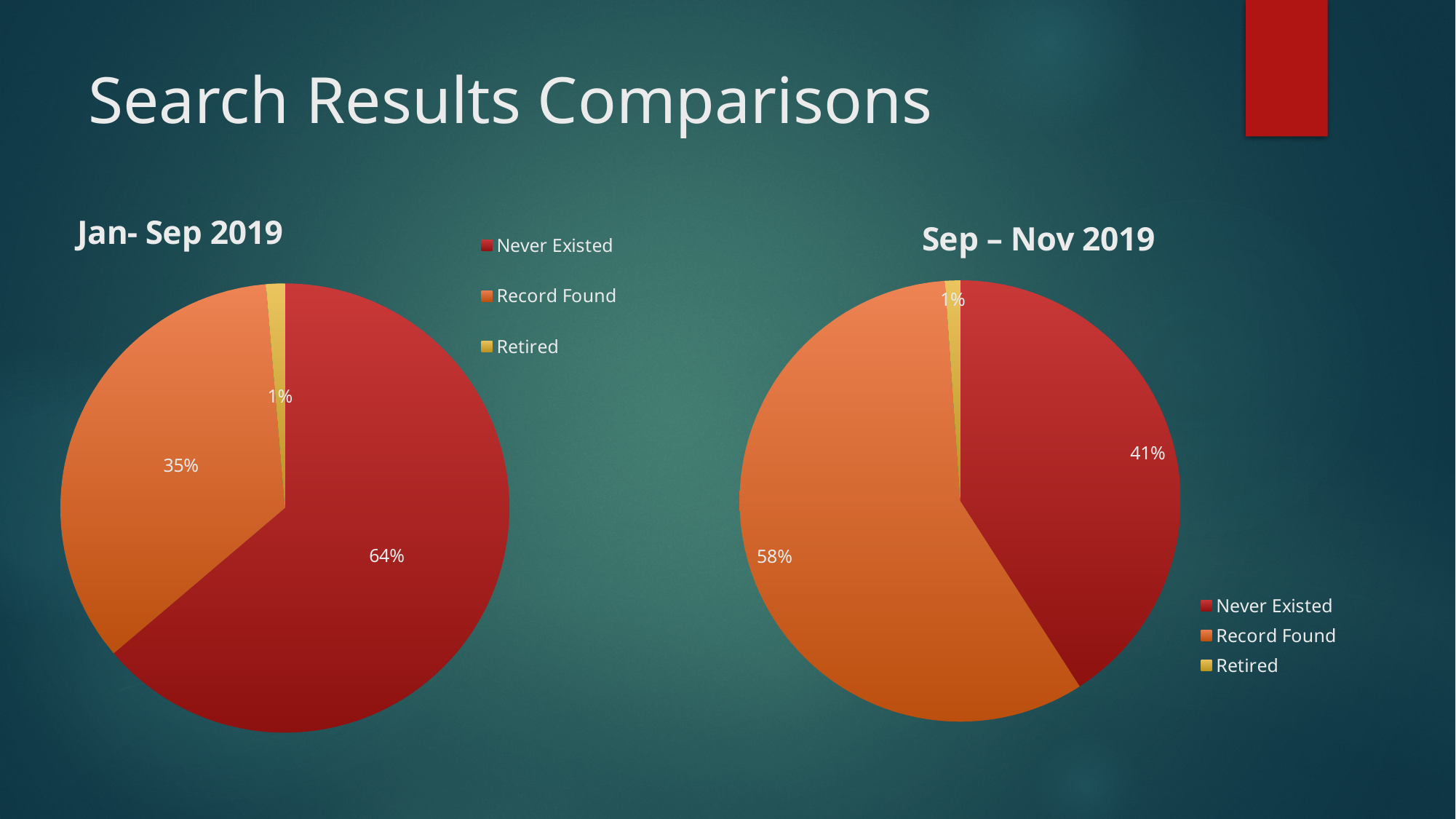
In the Sep – Nov 2019 chart, which is larger, Never Existed or Record Found? Record Found In the Jan- Sep 2019 chart, what share of the pie is Record Found? 35% In the Sep – Nov 2019 chart, which category has the largest slice? Record Found In the Sep – Nov 2019 chart, what share of the pie is Record Found? 58% In the Jan- Sep 2019 chart, which category has the smallest slice? Retired In the Sep – Nov 2019 chart, what share of the pie is Never Existed? 41% What type of chart is the Jan- Sep 2019 chart? Pie chart In the Jan- Sep 2019 chart, what is the difference between the Never Existed and Record Found shares? 29% How many slices does the Sep – Nov 2019 chart have? 3 In the Sep – Nov 2019 chart, what share of the pie is Retired? 1% In the Jan- Sep 2019 chart, what share of the pie is Never Existed? 64% In the Jan- Sep 2019 chart, which category has the largest slice? Never Existed